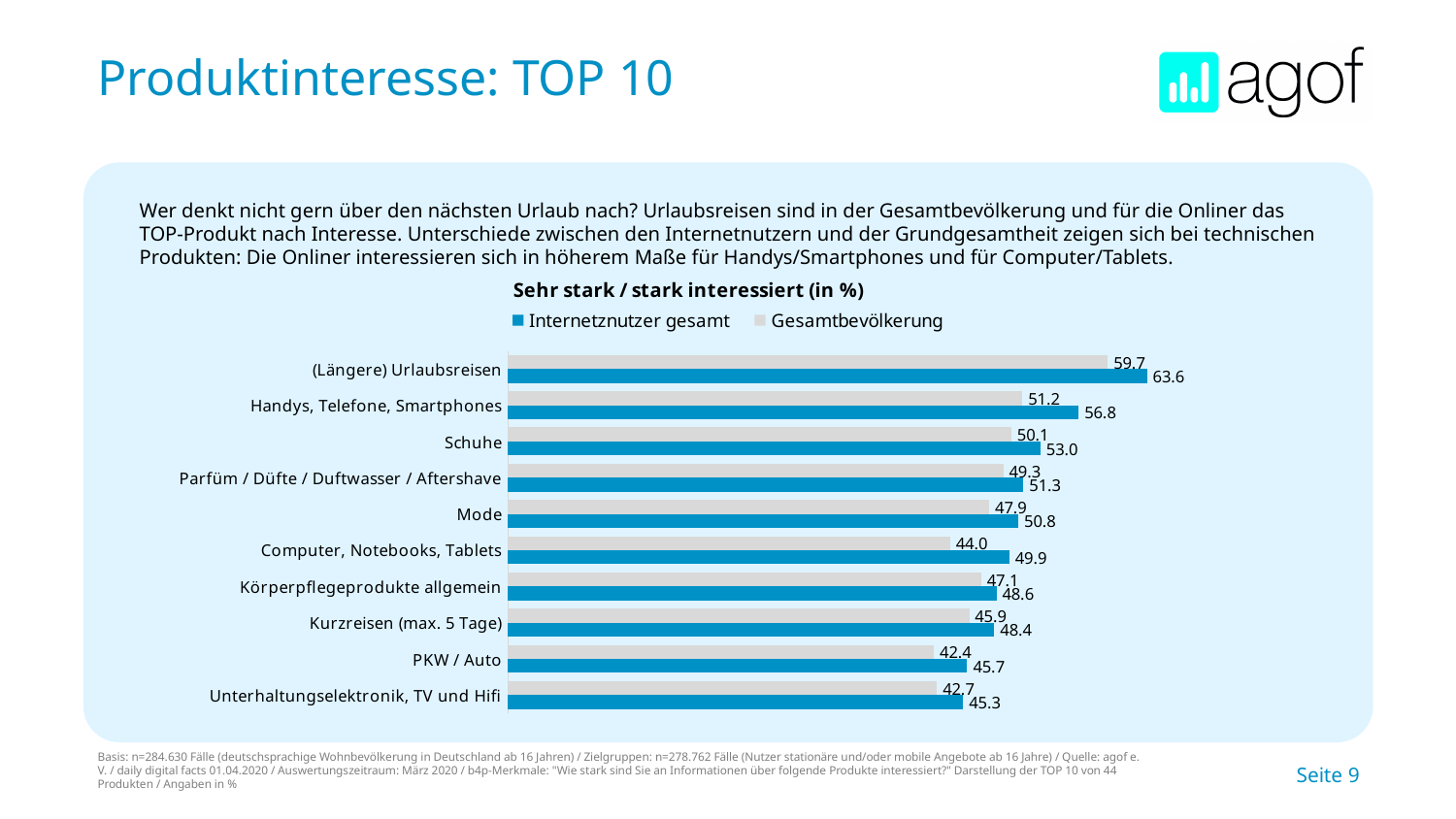
Which category has the lowest value for Gesamtbevölkerung? PKW / Auto Which series is shown in grey in the chart? Gesamtbevölkerung What is the difference between Internetnutzer gesamt and Gesamtbevölkerung for Handys, Telefone, Smartphones? 5.6 How many product categories are shown in the chart? 10 What is the value for Internetnutzer gesamt for (Längere) Urlaubsreisen? 63.6 What kind of chart is shown on the slide? Bar chart Which is larger for Schuhe: Internetnutzer gesamt or Gesamtbevölkerung? Internetnutzer gesamt How many series does the legend list? 2 What is the value for Gesamtbevölkerung for Computer, Notebooks, Tablets? 44.0 Which category has the highest value for Internetnutzer gesamt? (Längere) Urlaubsreisen What is the value for Internetnutzer gesamt for PKW / Auto? 45.7 What is the title of the chart? Sehr stark / stark interessiert (in %)